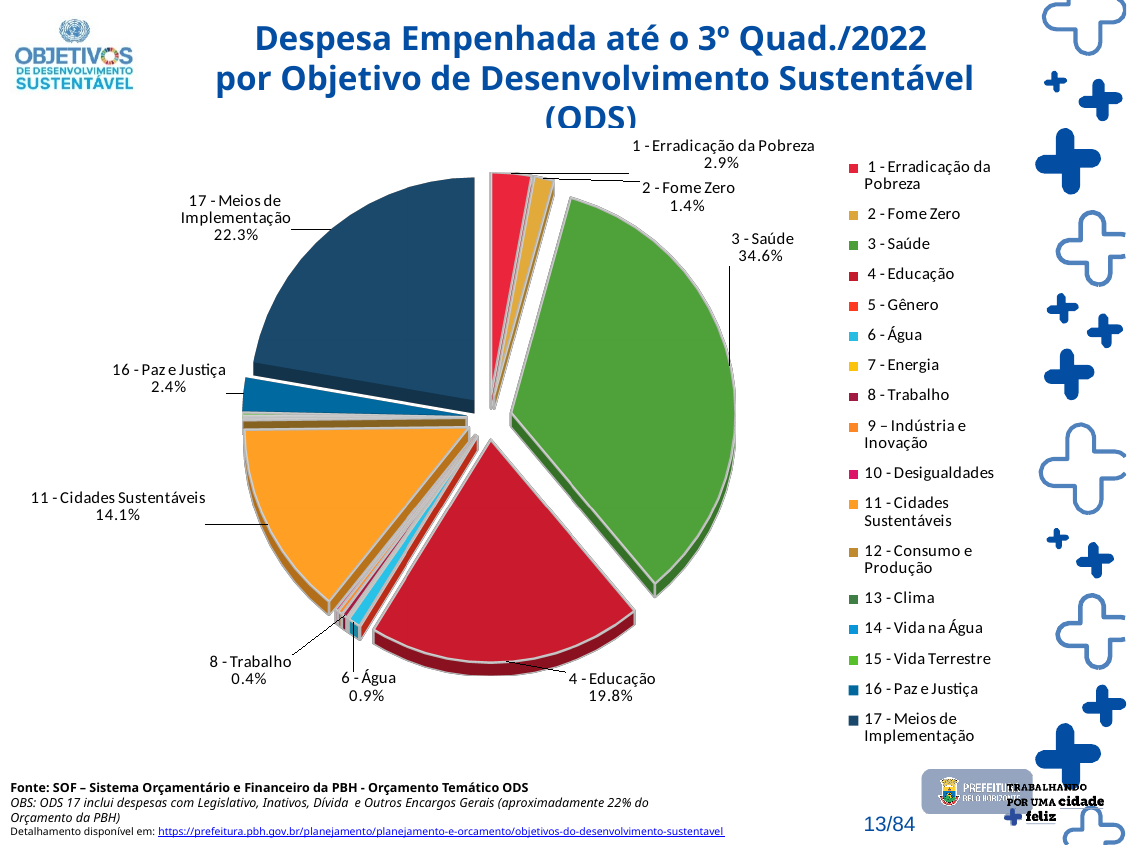
What percentage is shown for "8 - Trabalho"? 0.4% What is the difference in percentage points between "17 - Meios de Implementação" and "11 - Cidades Sustentáveis"? 8.2 What share of the pie does "3 - Saúde" represent? 34.6% What percentage is shown for "2 - Fome Zero"? 1.4% What is the difference in percentage points between "3 - Saúde" and "4 - Educação"? 14.8 How many entries does the legend list? 17 What percentage is shown for "4 - Educação"? 19.8% What percentage is shown for "11 - Cidades Sustentáveis"? 14.1% What percentage is shown for "17 - Meios de Implementação"? 22.3% Which has a larger share, "16 - Paz e Justiça" or "1 - Erradicação da Pobreza"? 1 - Erradicação da Pobreza Which ODS has the largest share of the pie? 3 - Saúde What type of chart is shown on the slide? Pie chart